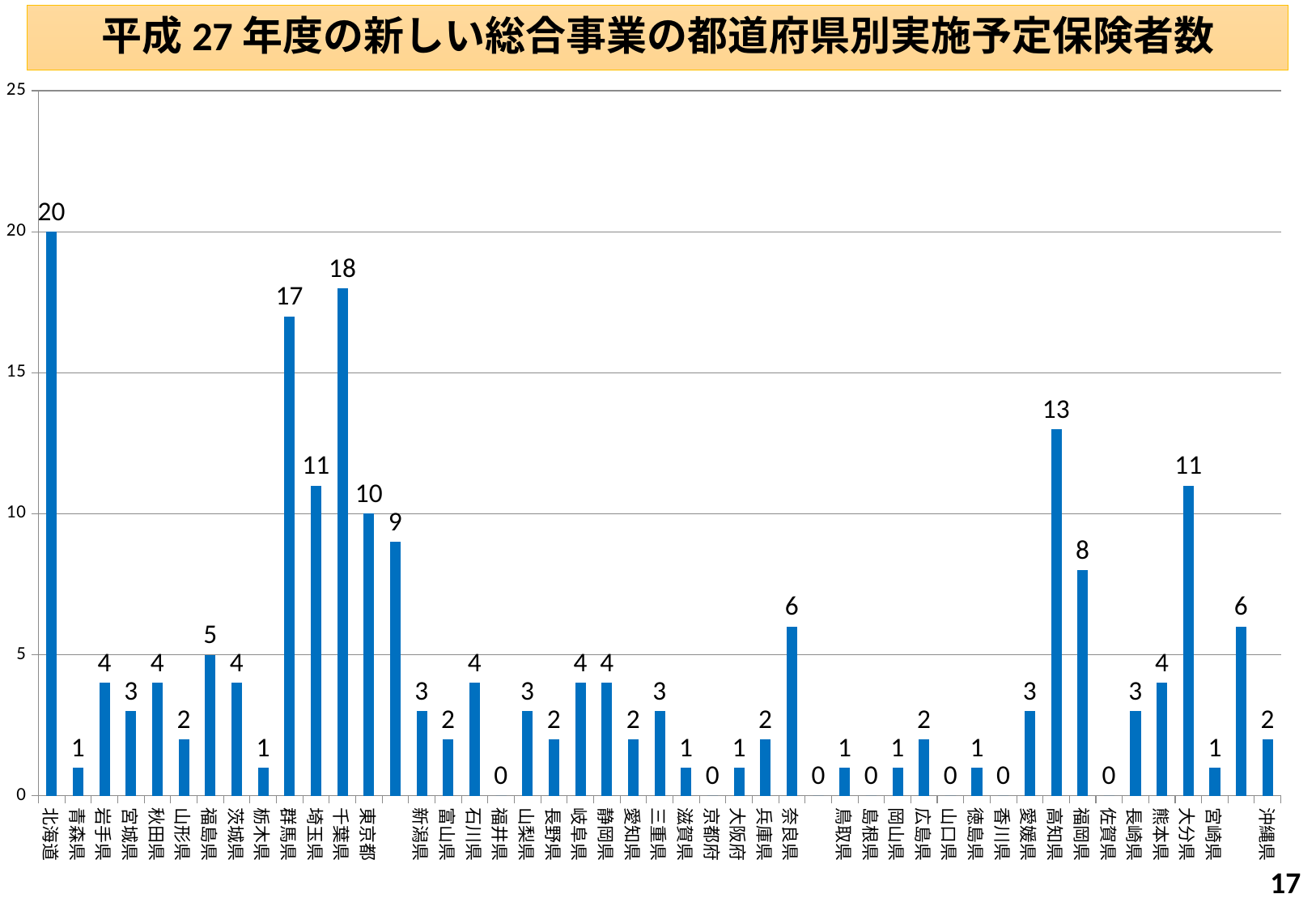
What is the value for 福井県? 0 What is the value for 福岡県? 8 What is the difference between the values for 千葉県 and 群馬県? 1 What is the value for 奈良県? 6 What is the value for 高知県? 13 What kind of chart is shown on the slide? bar chart Which prefecture has the highest value? 北海道 What is the difference between the values for 北海道 and 大分県? 9 What is the value for 北海道? 20 What is the value for 群馬県? 17 What is the title of the chart? 平成27年度の新しい総合事業の都道府県別実施予定保険者数 Which is larger, the value for 埼玉県 or the value for 東京都? 埼玉県